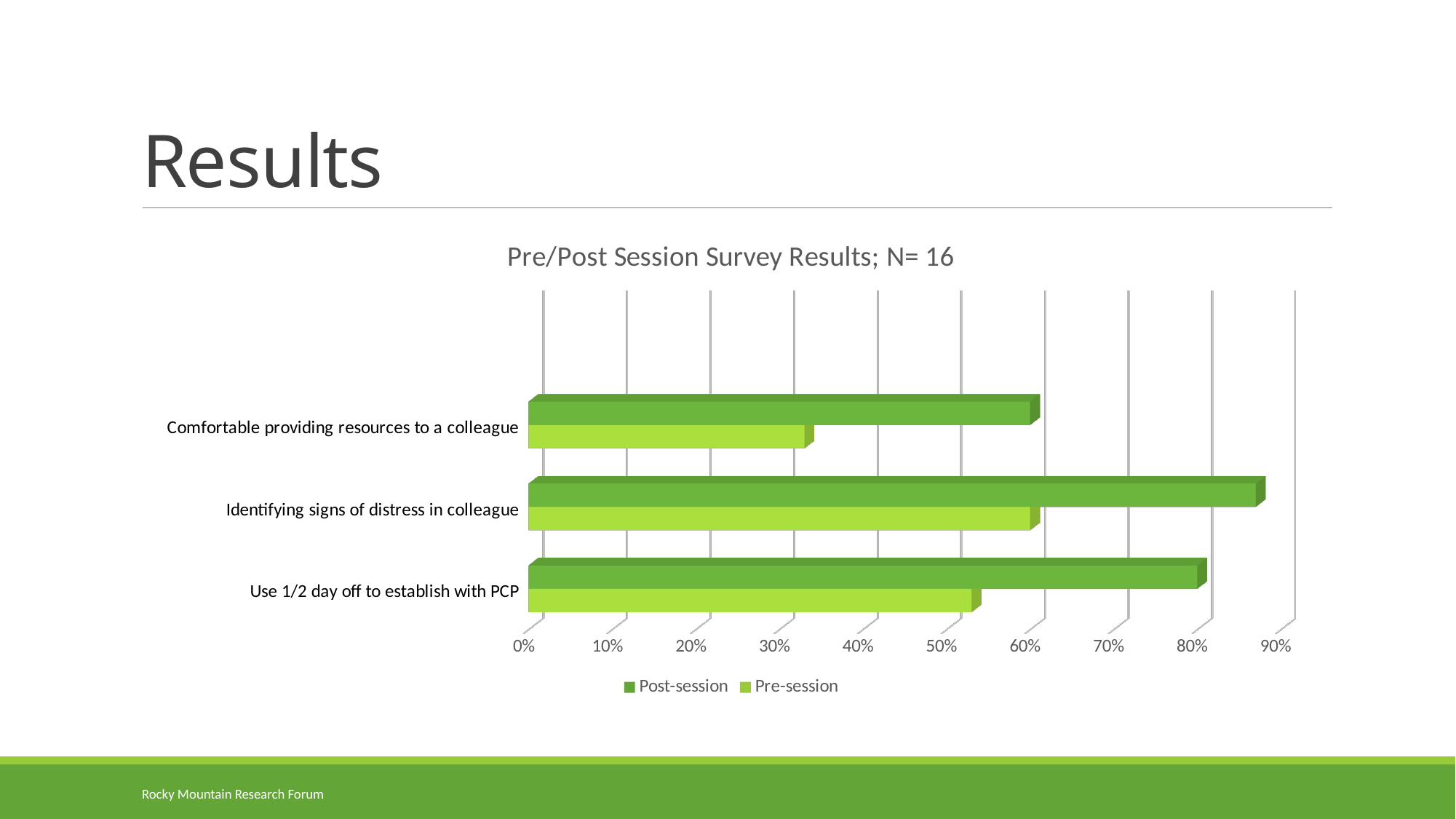
Which category has the highest Post-session value? Identifying signs of distress in colleague Which series is shown in the darker green colour? Post-session What kind of chart is shown on the slide? bar chart What is the title of the chart? Pre/Post Session Survey Results; N= 16 How many categories are shown on the chart? 3 How many series does the legend list? 2 Is the Post-session value for Use 1/2 day off to establish with PCP greater or less than 70%? greater For Comfortable providing resources to a colleague, which is larger: the Post-session or the Pre-session value? Post-session Which category has the lowest Pre-session value? Comfortable providing resources to a colleague Is the Post-session value for Identifying signs of distress in colleague greater or less than 80%? greater Is the Pre-session value for Comfortable providing resources to a colleague greater or less than 40%? less